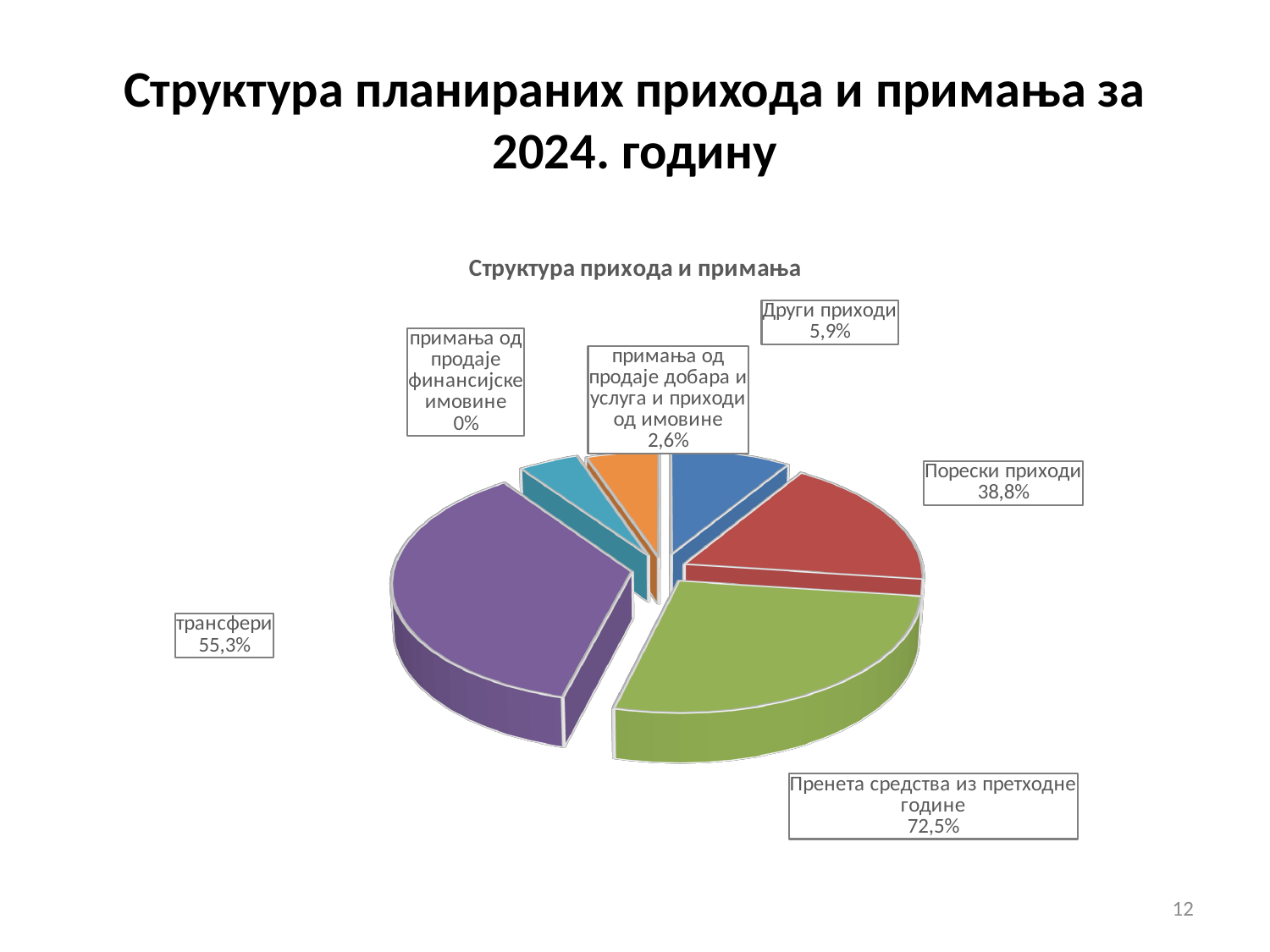
What is the difference in percentage points between трансфери and Порески приходи? 16,5 What percentage is shown for трансфери? 55,3% What is the title of the chart? Структура прихода и примања How many categories are shown in the pie chart? 6 What percentage is shown for примања од продаје добара и услуга и приходи од имовине? 2,6% What is the difference in percentage points between Други приходи and примања од продаје добара и услуга и приходи од имовине? 3,3 Which category has the largest slice in the pie chart? Пренета средства из претходне године What kind of chart is shown on the slide? Pie chart What percentage is shown for Порески приходи? 38,8% Which is larger, Порески приходи or трансфери? трансфери What percentage is shown for Други приходи? 5,9%